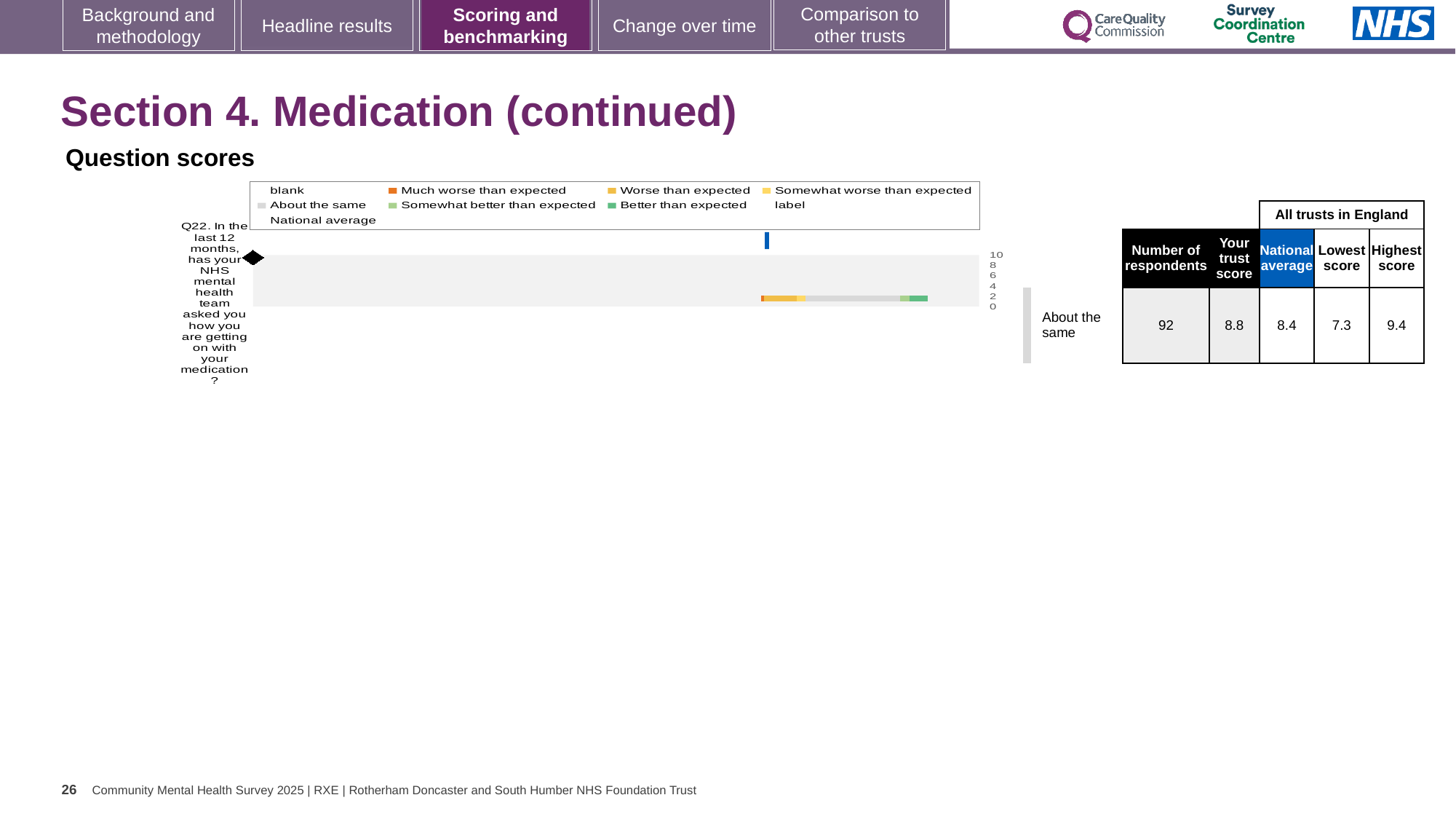
What is the difference between the highest and lowest scores among all trusts in England for Q22? 2.1 What is the lowest score among all trusts in England for Q22? 7.3 What is the national average score for Q22? 8.4 What is the maximum value shown on the score axis of the chart? 10 Which benchmarking category does the trust's Q22 score fall into? About the same How many respondents answered Q22? 92 Which is larger for Q22, the trust score or the national average? trust score How many survey questions are plotted in the question scores chart? 1 What is the highest score among all trusts in England for Q22? 9.4 What is the trust score for Q22 about the mental health team asking how you are getting on with your medication? 8.8 What is the difference between the trust score and the national average for Q22? 0.4 What kind of chart is shown for the Q22 question score? bar chart